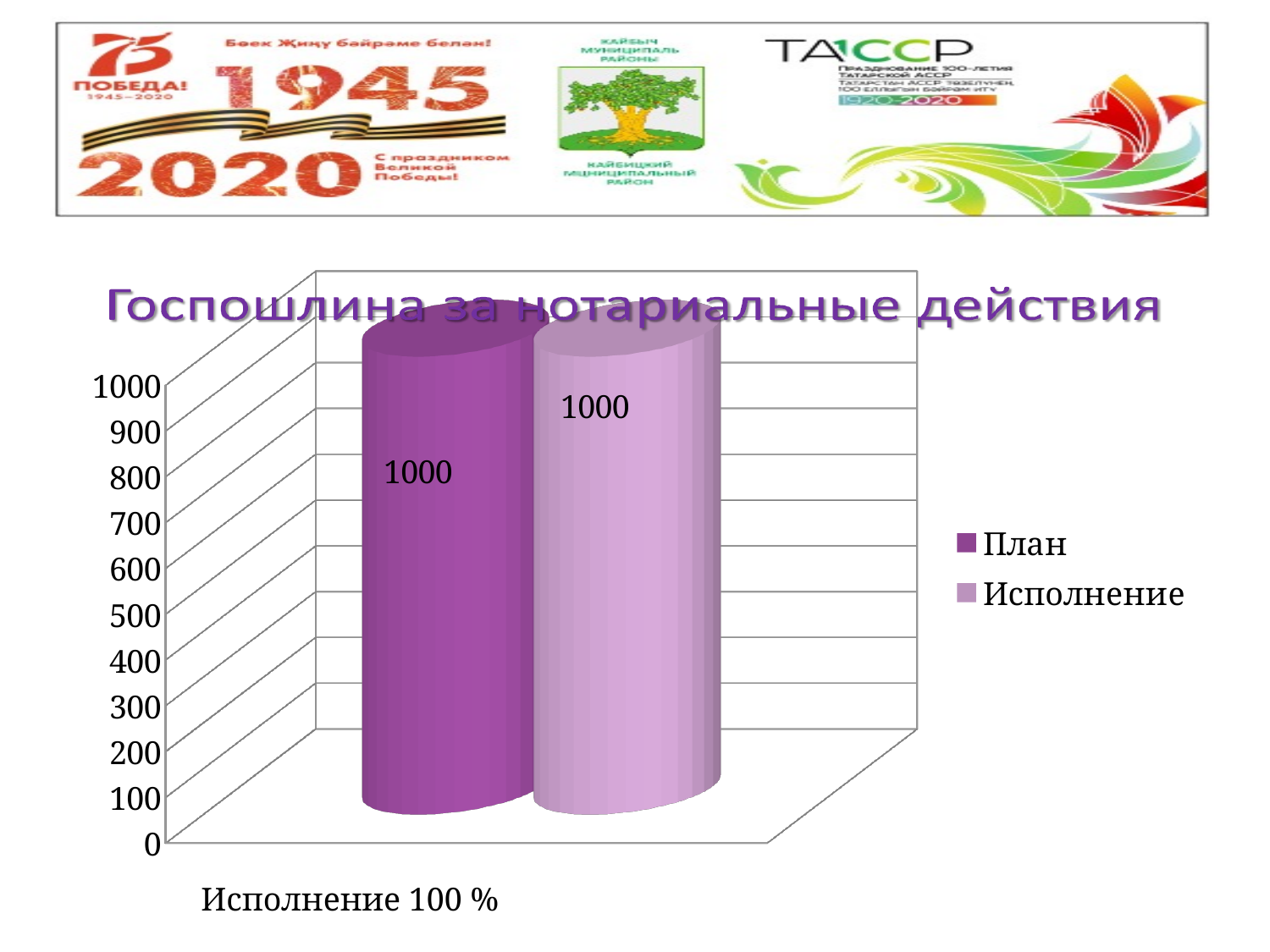
What kind of chart is shown on the slide? Bar chart What is the highest value shown on the vertical axis? 1000 What is the value of the План bar? 1000 Which series is shown in the darker purple colour? План What is the difference between the План and Исполнение values? 0 What execution percentage is stated below the chart? 100 % What is the title of the chart? Госпошлина за нотариальные действия How many series does the legend list? 2 Is the value for План greater or less than 500? greater Is the value for Исполнение greater or less than 900? greater How many bars are plotted in the chart? 2 What is the value of the Исполнение bar? 1000